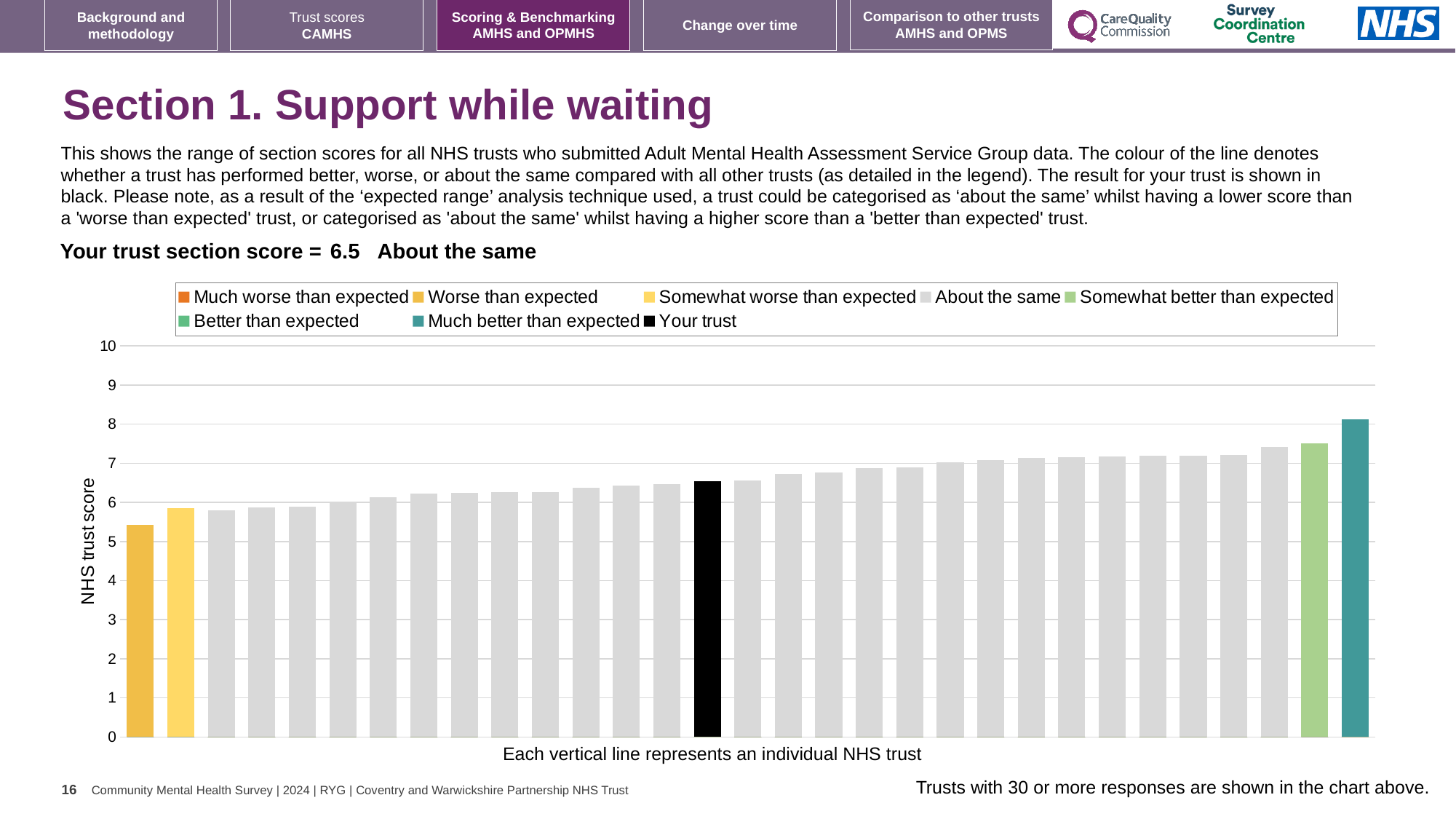
What is the label on the vertical axis of the chart? NHS trust score How many entries does the chart legend list? 8 Is the value of the black 'Your trust' bar greater or less than 6? greater Is the value of the leftmost bar greater or less than 6? less What kind of chart is shown on the slide? bar chart What category does your trust fall into according to the slide? About the same Is the value of the rightmost bar greater or less than 7? greater What is the section score for your trust shown on the slide? 6.5 Which bar is higher, the leftmost bar or the rightmost bar? the rightmost bar How many bars are coloured as 'Much better than expected' (teal)? 1 Do the bar values rise or fall from left to right along the x axis? rise What is the highest value shown on the vertical axis? 10